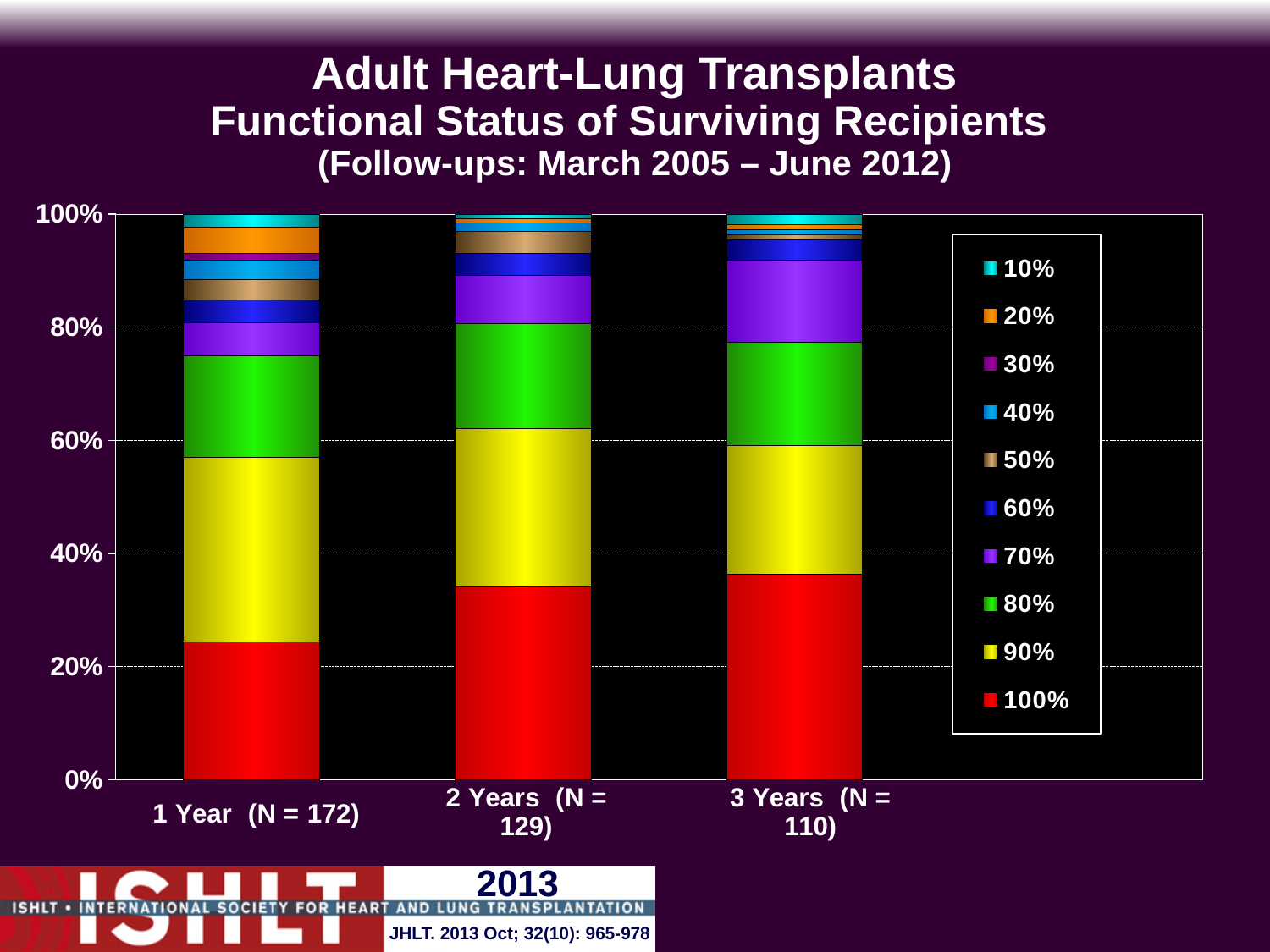
How many series does the legend list? 10 Which colour represents the 100% functional status series in the legend? Red Is the 70% (purple) segment larger for 1 Year or for 3 Years? 3 Years Which category has the largest 100% (red) segment? 3 Years (N = 110) Is the 100% (red) segment for 3 Years greater or less than 40%? less Which category has the smallest 100% (red) segment? 1 Year (N = 172) How many follow-up time categories are shown on the x axis? 3 Is the 100% (red) segment for 1 Year greater or less than 20%? greater Is the combined height of the 100% and 90% segments for 1 Year greater or less than 60%? less What is the sample size (N) shown for the 2 Years category? 129 What kind of chart is shown on the slide? Stacked bar chart What is the title of the chart? Adult Heart-Lung Transplants Functional Status of Surviving Recipients (Follow-ups: March 2005 – June 2012)